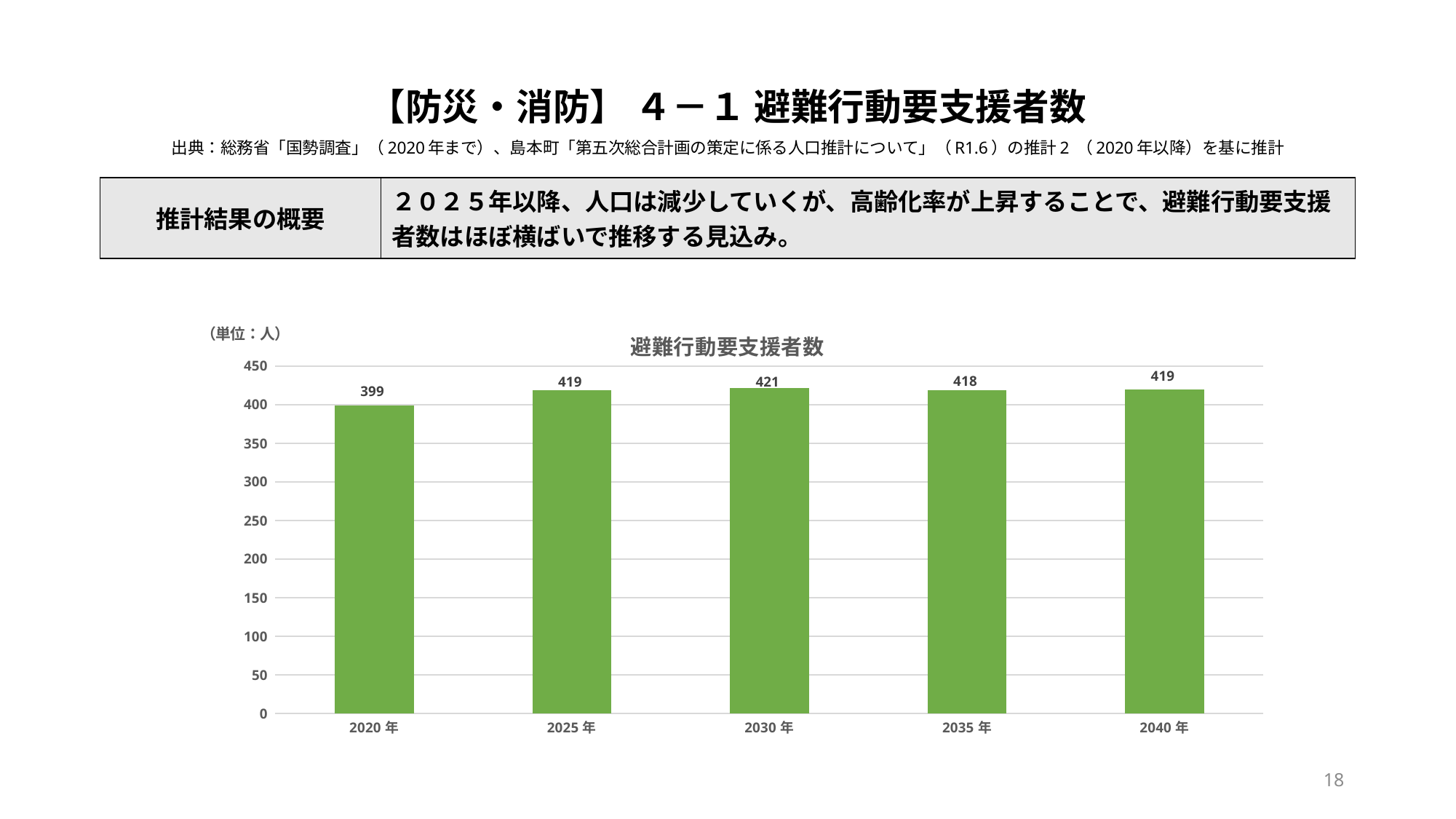
What is the difference between the values for 2030年 and 2020年 in the 避難行動要支援者数 chart? 22 What kind of chart is the 避難行動要支援者数 chart? bar chart What is the value for 2020年 in the 避難行動要支援者数 chart? 399 Is the value for 2020年 greater or less than 400 in the 避難行動要支援者数 chart? less What is the difference between the values for 2025年 and 2035年 in the 避難行動要支援者数 chart? 1 What is the value for 2035年 in the 避難行動要支援者数 chart? 418 What is the value for 2030年 in the 避難行動要支援者数 chart? 421 How many years are shown on the x axis of the 避難行動要支援者数 chart? 5 What is the value for 2040年 in the 避難行動要支援者数 chart? 419 Which year has the lowest value in the 避難行動要支援者数 chart? 2020年 What unit is indicated for the values in the 避難行動要支援者数 chart? 人 Which year has the highest value in the 避難行動要支援者数 chart? 2030年